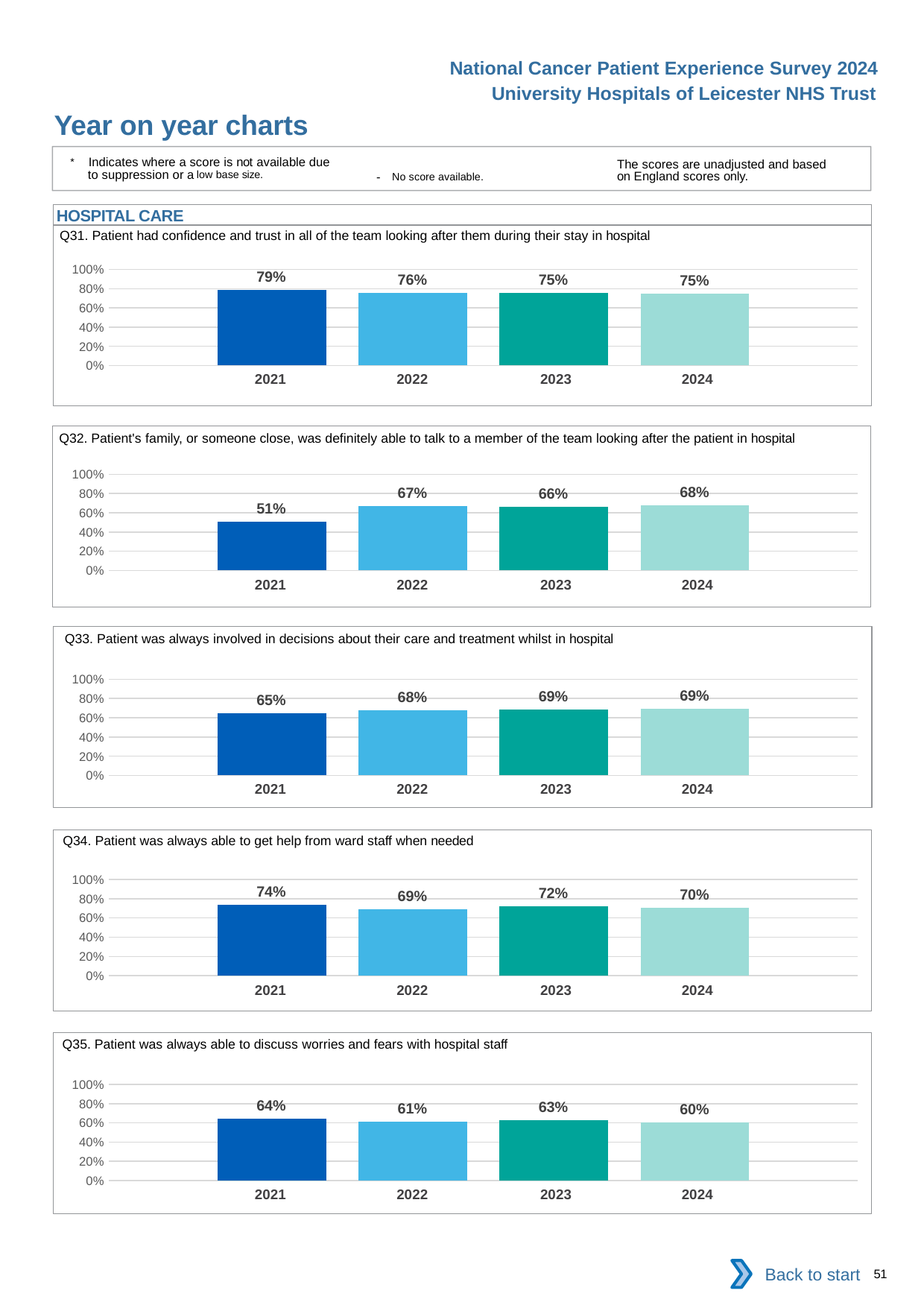
In the Q32 chart (patient's family was definitely able to talk to a member of the team), what is the value for 2021? 51% In the Q31 chart, which year has the highest value? 2021 In the Q32 chart, what is the difference between the 2024 value and the 2021 value? 17% How many years (bars) are shown in the Q31 chart? 4 In the Q32 chart, which year has the lowest value? 2021 In the Q35 chart (patient was always able to discuss worries and fears), which year has the lowest value? 2024 In the Q31 chart (patient had confidence and trust in all of the team), what is the value for 2021? 79% In the Q34 chart, what is the value for 2023? 72% In the Q33 chart (patient was always involved in decisions about their care), what is the value for 2022? 68% In the Q34 chart (patient was always able to get help from ward staff), which is larger, the 2021 value or the 2022 value? 2021 In the Q33 chart, do the values generally rise or fall from 2021 to 2024? rise In the Q35 chart, what is the difference between the 2021 value and the 2024 value? 4%